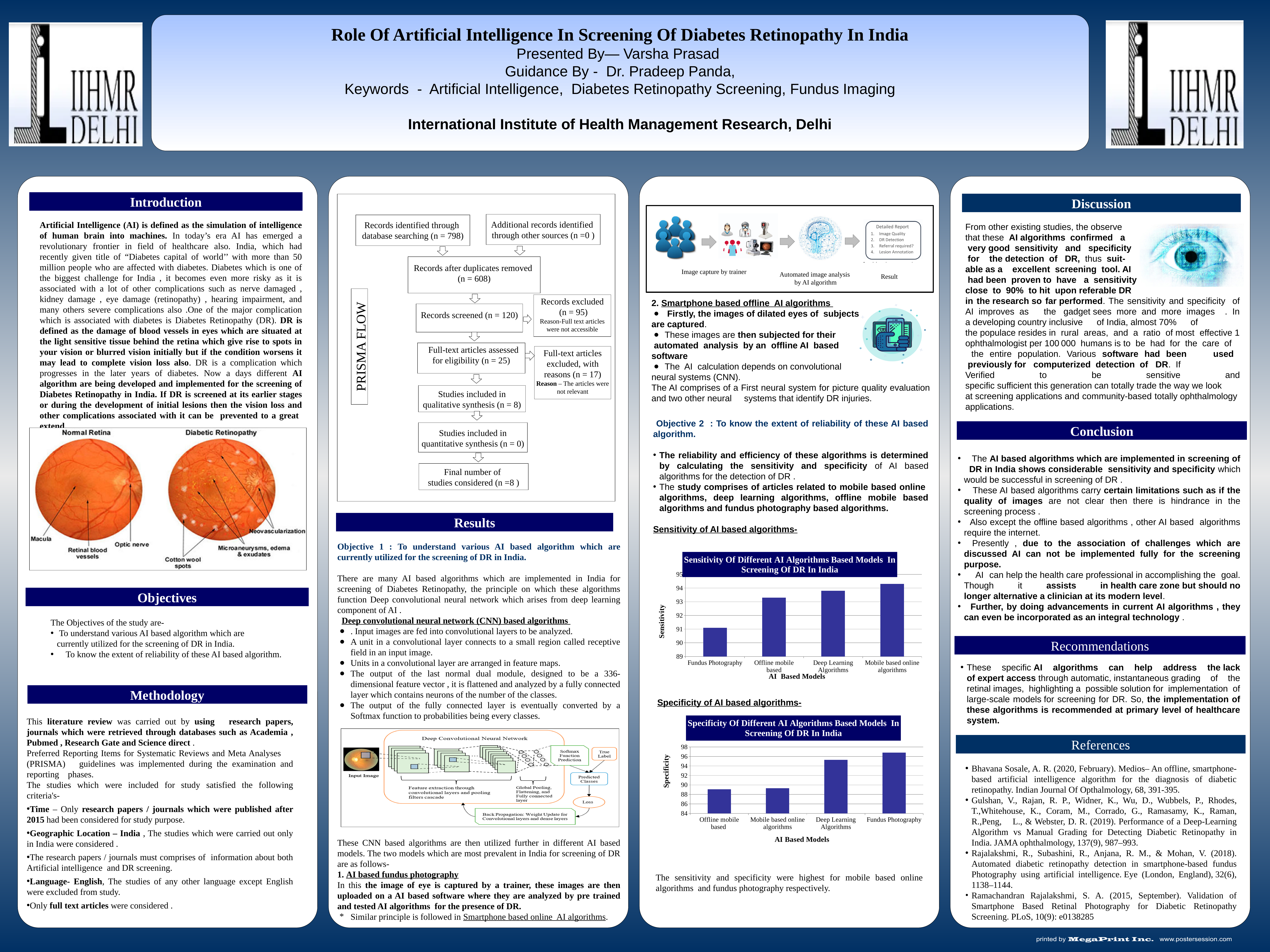
In the Specificity chart, is the value for Offline mobile based greater or less than 90? less In the Specificity chart, is the value for Deep Learning Algorithms greater or less than 94? greater What is the x-axis label of the Specificity chart? AI Based Models In the Sensitivity chart, which has the larger value: Fundus Photography or Offline mobile based? Offline mobile based In the Sensitivity chart, is the value for Deep Learning Algorithms greater or less than 93? greater What kind of chart is the 'Sensitivity Of Different AI Algorithms Based Models In Screening Of DR In India' chart? bar chart In the Specificity chart, which AI based model has the highest specificity? Fundus Photography In the Specificity chart, which has the larger value: Mobile based online algorithms or Deep Learning Algorithms? Deep Learning Algorithms In the Sensitivity chart, how many AI based models are plotted? 4 In the Sensitivity chart, which AI based model has the highest sensitivity? Mobile based online algorithms In the Sensitivity chart, which AI based model has the lowest sensitivity? Fundus Photography